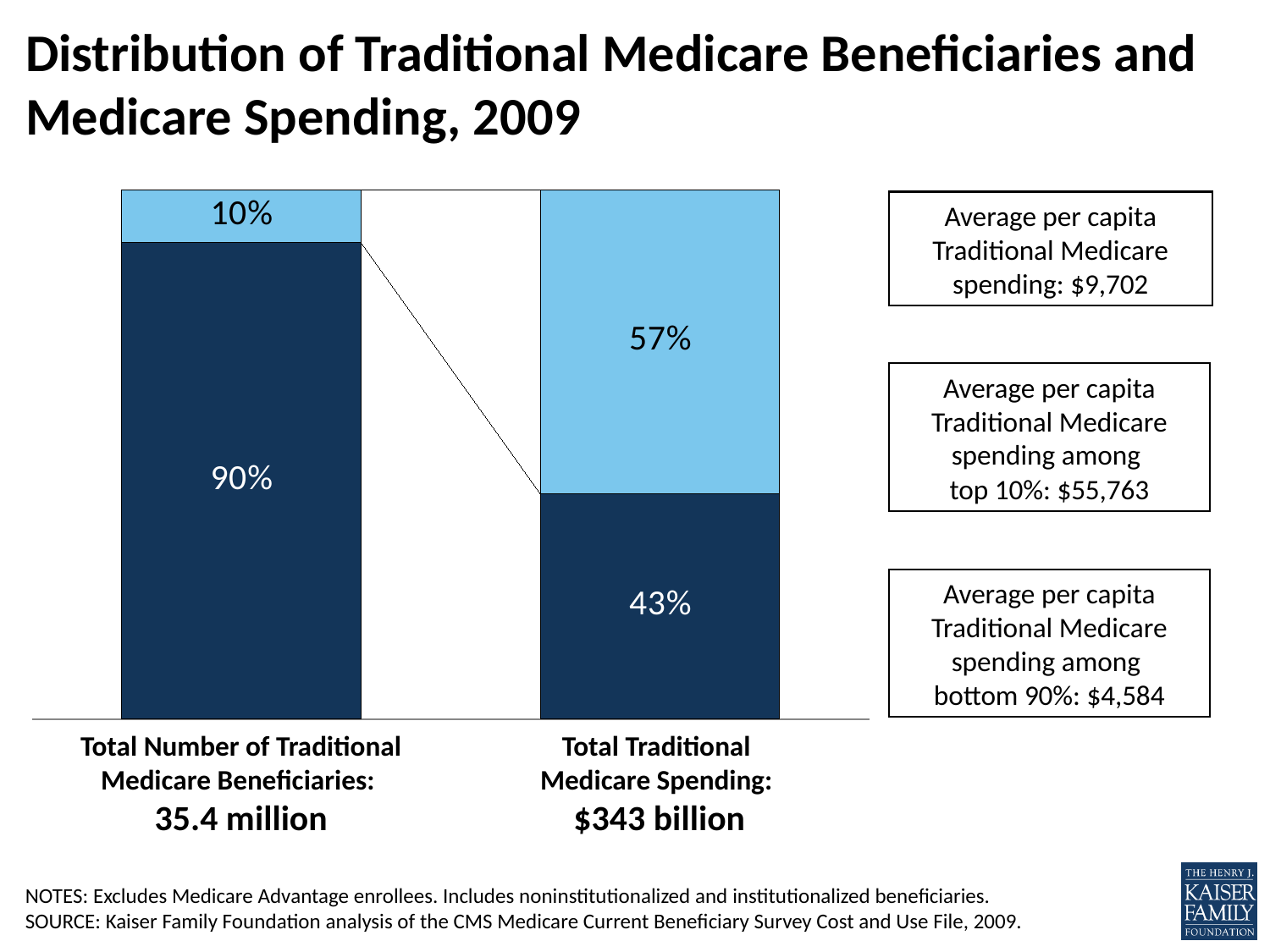
What percentage of Total Number of Traditional Medicare Beneficiaries does the dark blue segment represent? 90% What is the Total Number of Traditional Medicare Beneficiaries shown below the left bar? 35.4 million What is the title of the chart on the slide? Distribution of Traditional Medicare Beneficiaries and Medicare Spending, 2009 What share of Total Traditional Medicare Spending is attributed to the top 10% of beneficiaries? 57% In the Total Traditional Medicare Spending bar, which segment is larger: the top 10% or the bottom 90%? top 10% How many bars are shown in the chart? 2 What share of Total Traditional Medicare Spending is attributed to the bottom 90% of beneficiaries? 43% What is the total of the two segments in the Total Traditional Medicare Spending bar? 100% What type of chart is shown on the slide? Stacked bar chart What is the Total Traditional Medicare Spending shown below the right bar? $343 billion According to the text box on the slide, what is the average per capita Traditional Medicare spending among the top 10%? $55,763 What is the difference in percentage points between the top 10% share of spending and the bottom 90% share of spending? 14